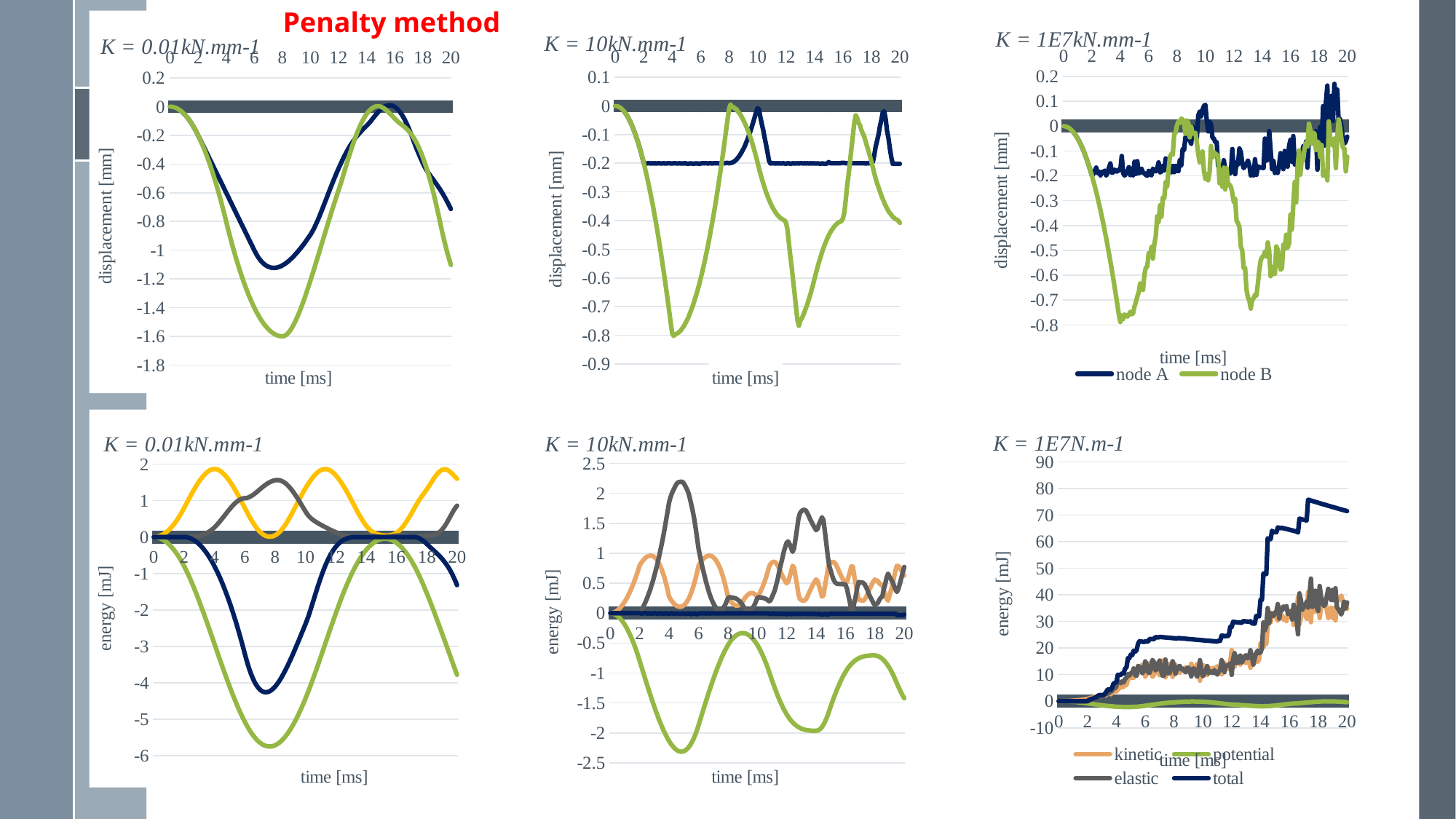
What kind of chart is the top-left chart titled 'K = 0.01kN.mm-1'? line chart In the bottom-right chart titled 'K = 1E7N.m-1', which is larger at time 20, total or kinetic? total In the bottom-left chart titled 'K = 0.01kN.mm-1', is the lowest value reached by the potential series greater or less than -5? less How many series does the legend of the bottom-right chart titled 'K = 1E7N.m-1' list? 4 What is the y-axis label of the top-left chart titled 'K = 0.01kN.mm-1'? displacement [mm] In the top-middle chart titled 'K = 10kN.mm-1', is the value of node A at time 4 greater or less than -0.1? less How many series does the legend of the top-right chart titled 'K = 1E7kN.mm-1' list? 2 In the bottom-right chart titled 'K = 1E7N.m-1', is the value of total at time 20 greater or less than 60? greater In the bottom-right chart titled 'K = 1E7N.m-1', does the total series generally rise or fall from time 0 to time 20? rise What are the two legend entries of the top-right chart titled 'K = 1E7kN.mm-1'? node A, node B